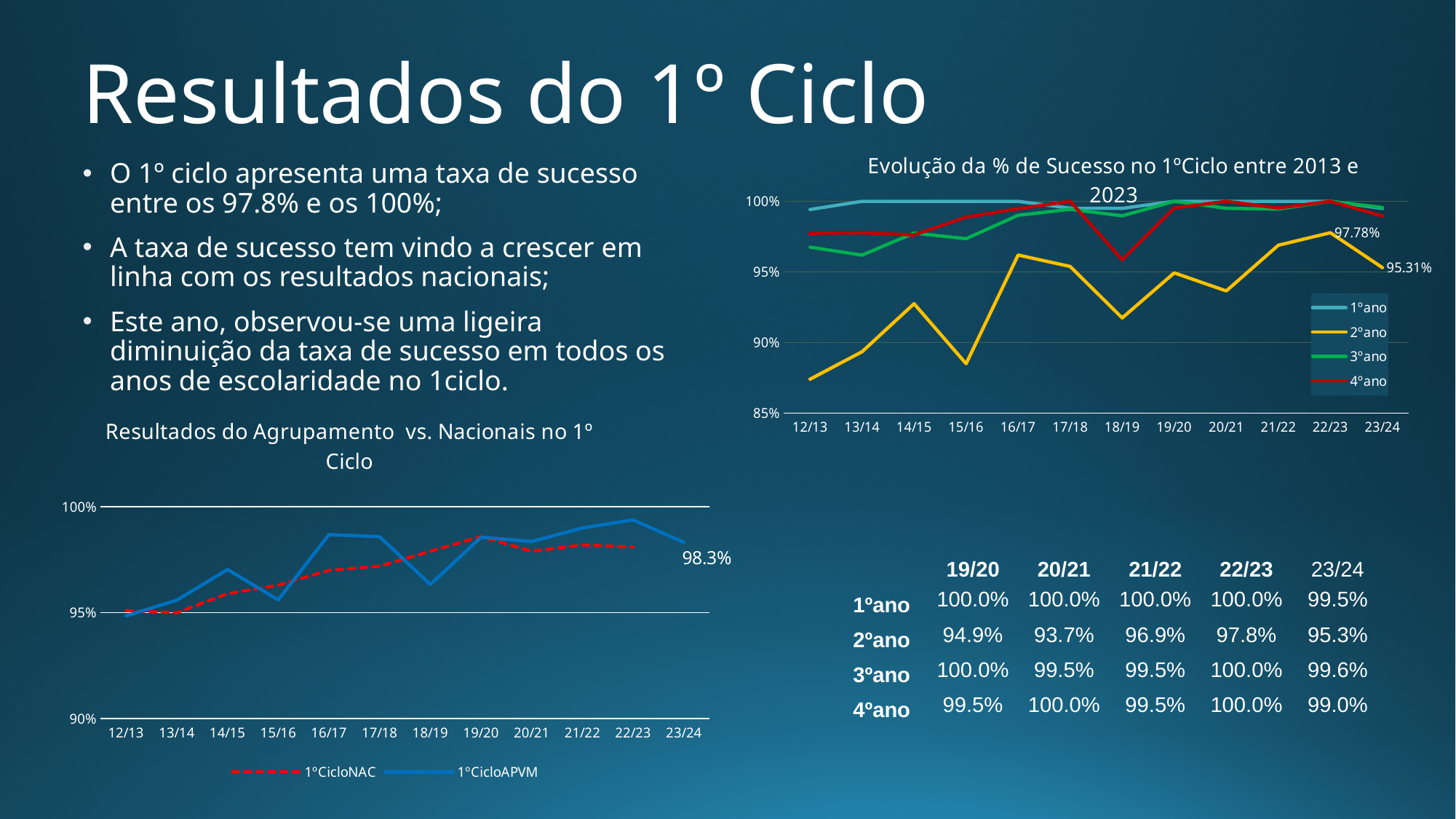
In 'Resultados do Agrupamento vs. Nacionais no 1º Ciclo', what is the labelled value for 1ºCicloAPVM in 23/24? 98.3% Which two series does the legend of 'Resultados do Agrupamento vs. Nacionais no 1º Ciclo' list? 1ºCicloNAC and 1ºCicloAPVM What kind of chart is 'Evolução da % de Sucesso no 1ºCiclo entre 2013 e 2023'? Line chart In 'Evolução da % de Sucesso no 1ºCiclo entre 2013 e 2023', what is the labelled value for 2ºano in 22/23? 97.78% What kind of chart is 'Resultados do Agrupamento vs. Nacionais no 1º Ciclo'? Line chart In 'Evolução da % de Sucesso no 1ºCiclo entre 2013 e 2023', what is the labelled value for 2ºano in 23/24? 95.31% In 'Evolução da % de Sucesso no 1ºCiclo entre 2013 e 2023', is the value for 2ºano in 15/16 greater or less than 90%? less In 'Evolução da % de Sucesso no 1ºCiclo entre 2013 e 2023', by how much did the 2ºano value drop from 22/23 to 23/24? 2.47% In 'Evolução da % de Sucesso no 1ºCiclo entre 2013 e 2023', which series has the lowest value in 12/13? 2ºano How many school years are shown on the x axis of 'Evolução da % de Sucesso no 1ºCiclo entre 2013 e 2023'? 12 How many series does the legend of 'Evolução da % de Sucesso no 1ºCiclo entre 2013 e 2023' list? 4 In 'Resultados do Agrupamento vs. Nacionais no 1º Ciclo', which series is higher in 18/19, 1ºCicloNAC or 1ºCicloAPVM? 1ºCicloNAC